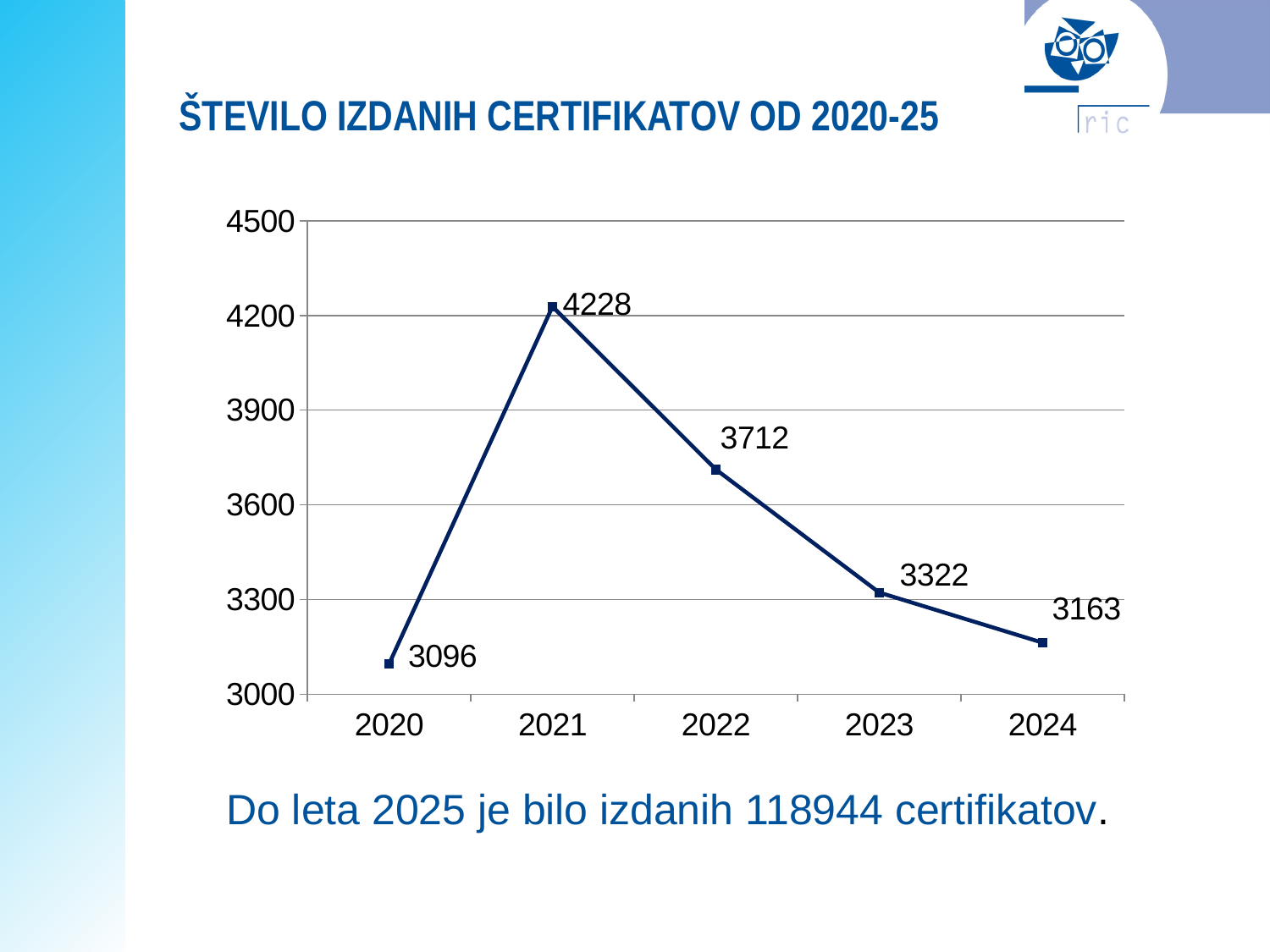
How many years are plotted on the chart? 5 Which year has the lowest value? 2020 What is the value for 2021? 4228 What is the difference between the values for 2023 and 2024? 159 What is the value for 2024? 3163 What kind of chart is shown on the slide? line chart What is the value for 2020? 3096 Do the values rise or fall from 2021 to 2024? fall What is the difference between the values for 2021 and 2022? 516 Which year has the highest value? 2021 Which is larger, the value for 2022 or the value for 2023? 2022 Is the value for 2022 greater or less than 3600? greater